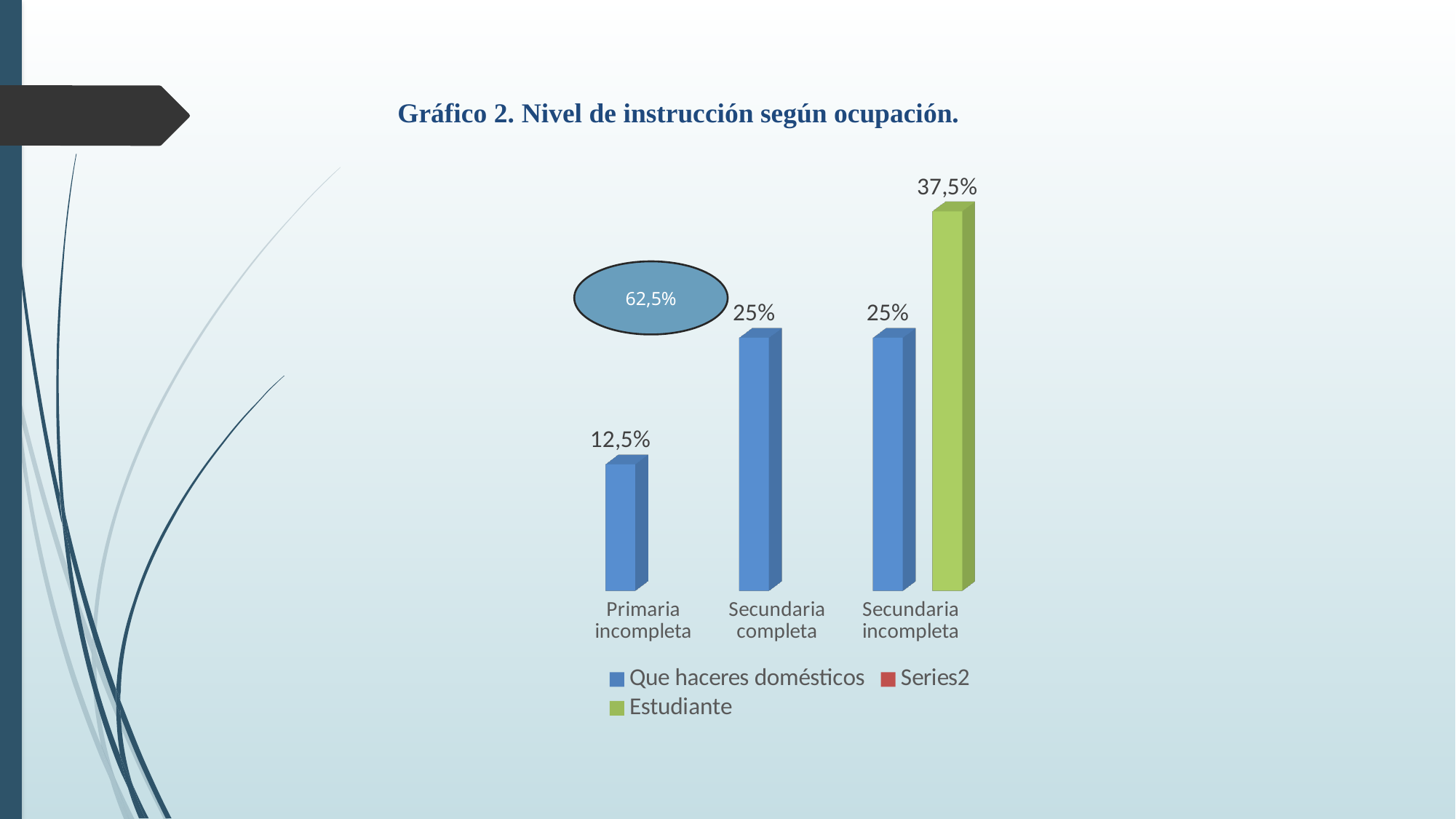
How many categories are shown on the x axis? 3 In the Secundaria incompleta category, which is larger: Que haceres domésticos or Estudiante? Estudiante What is the difference between the Que haceres domésticos values for Secundaria completa and Primaria incompleta? 12,5% What is the value for Que haceres domésticos in the Primaria incompleta category? 12,5% Which category has the lowest value for Que haceres domésticos? Primaria incompleta How many series does the legend list? 3 What is the title of the chart? Gráfico 2. Nivel de instrucción según ocupación. What is the value for Que haceres domésticos in the Secundaria incompleta category? 25% What is the difference between the Estudiante value and the Que haceres domésticos value in the Secundaria incompleta category? 12,5% What is the value for Estudiante in the Secundaria incompleta category? 37,5% What is the value for Que haceres domésticos in the Secundaria completa category? 25% What kind of chart is shown on the slide? Bar chart